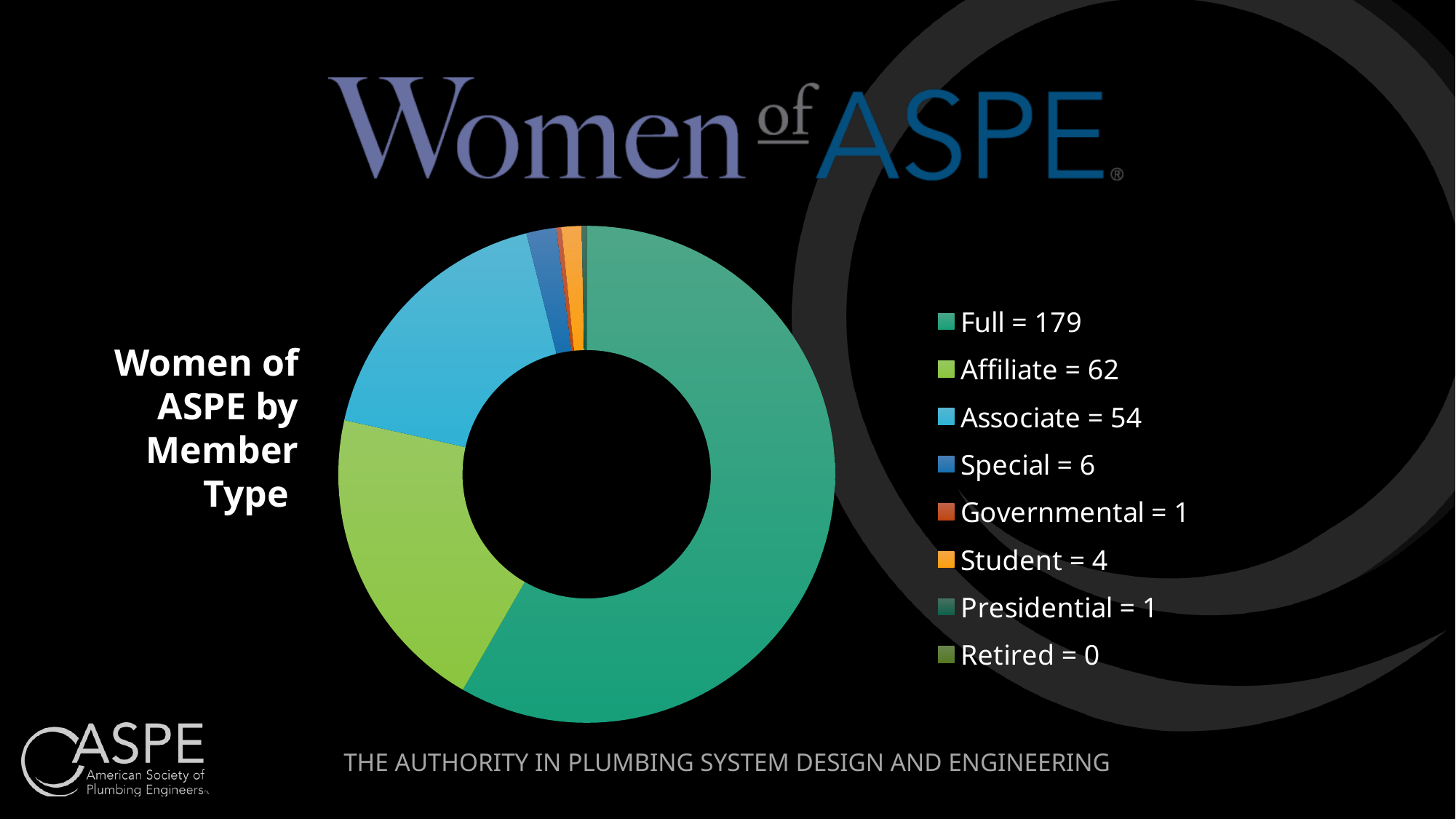
Which member type has the highest value in the chart? Full What is the value for Associate members? 54 Which member type has the lowest value in the chart? Retired How many Affiliate members are shown in the chart? 62 What is the value for Full members in the Women of ASPE by Member Type chart? 179 What kind of chart is shown on the slide? Doughnut (pie) chart What is the value for Special members? 6 What is the value for Student members? 4 How many member types are listed in the chart legend? 8 Which is larger, the Affiliate value or the Associate value? Affiliate What is the title of the chart on the slide? Women of ASPE by Member Type What is the difference between the Full and Affiliate values? 117